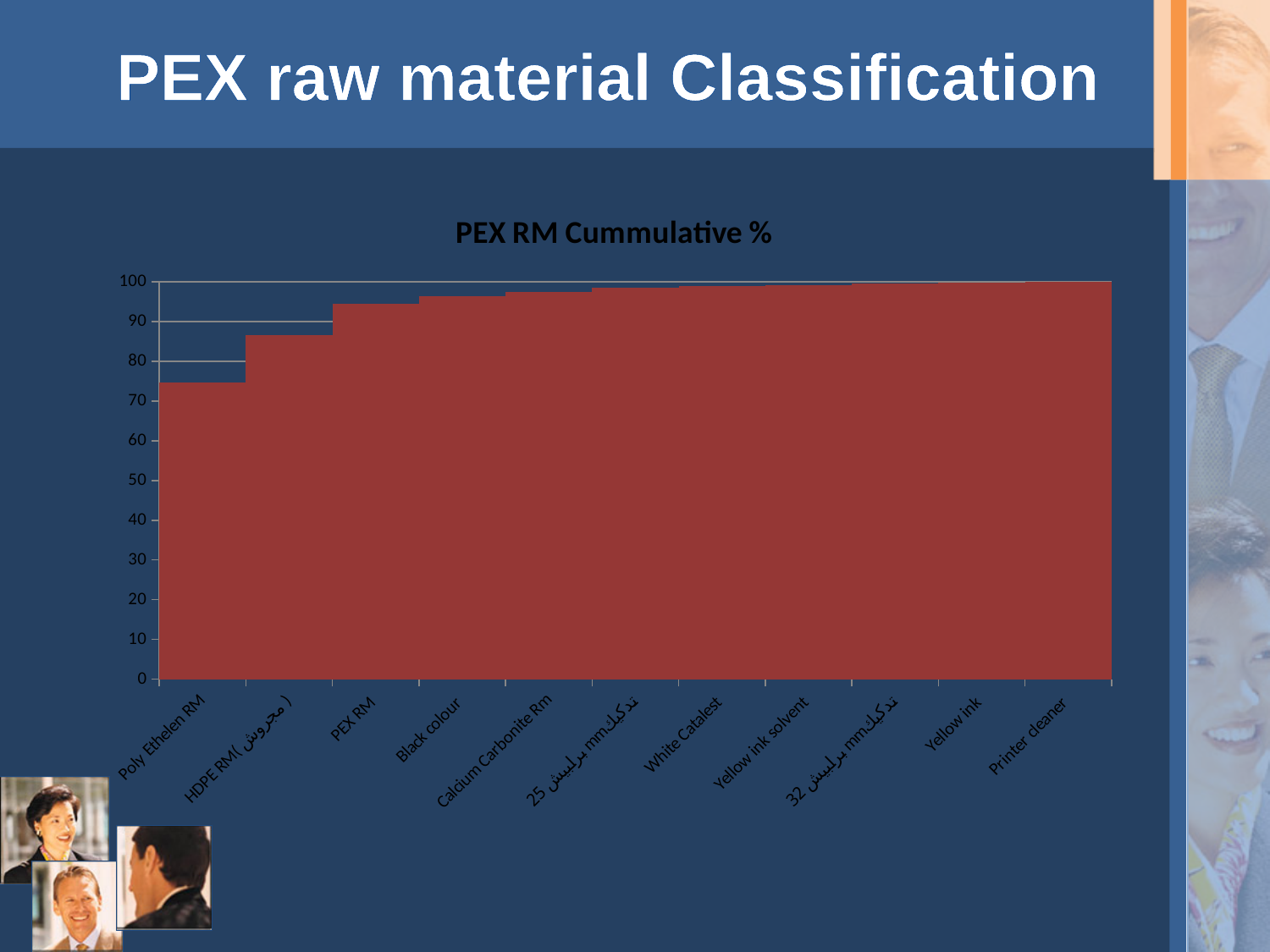
Is the value for HDPE RM greater or less than 80? greater What kind of chart is shown on the slide? bar chart Do the values rise or fall from left to right along the x axis? rise What colour are the bars in the chart? red How many categories are shown on the x axis of the chart? 11 What is the title of the chart? PEX RM Cummulative % Is the value for Poly Ethelen RM greater or less than 70? greater Which category has the lowest value in the chart? Poly Ethelen RM Is the value for PEX RM greater or less than 90? greater Which is larger, the value for Poly Ethelen RM or the value for PEX RM? PEX RM